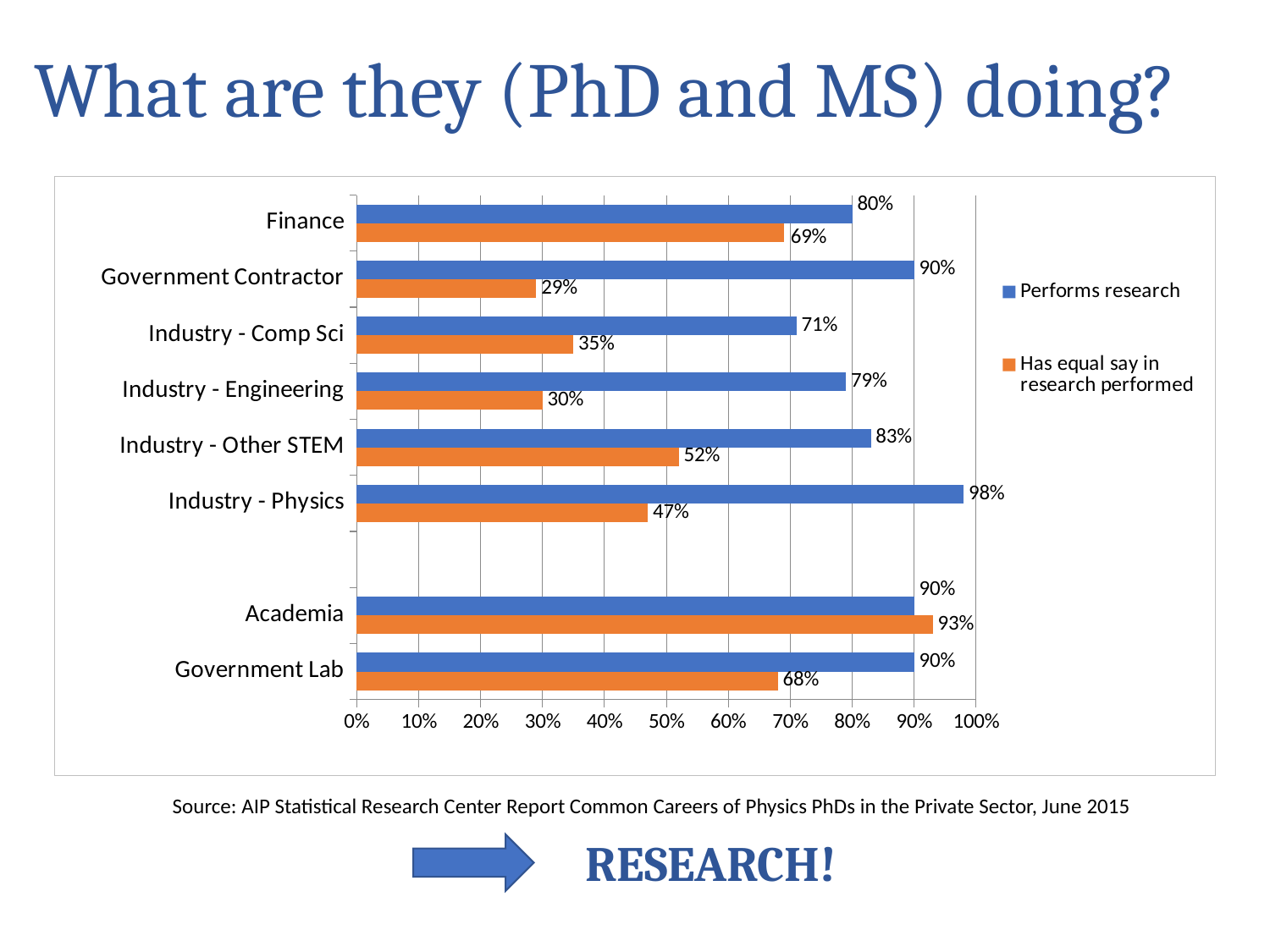
What colour are the 'Performs research' bars? Blue What is the 'Has equal say in research performed' value for Academia? 93% For Academia, which is larger: 'Performs research' or 'Has equal say in research performed'? Has equal say in research performed For Industry - Physics, what is the difference between the 'Performs research' value and the 'Has equal say in research performed' value? 51 percentage points What kind of chart is shown on the slide? Bar chart Which category has the lowest 'Has equal say in research performed' value? Government Contractor Which category has the highest 'Performs research' value? Industry - Physics What is the 'Has equal say in research performed' value for Government Contractor? 29% Which has a higher 'Has equal say in research performed' value: Finance or Industry - Other STEM? Finance How many series does the legend list? 2 What percentage of those in Industry - Physics perform research? 98% Which category has the lowest 'Performs research' value? Industry - Comp Sci